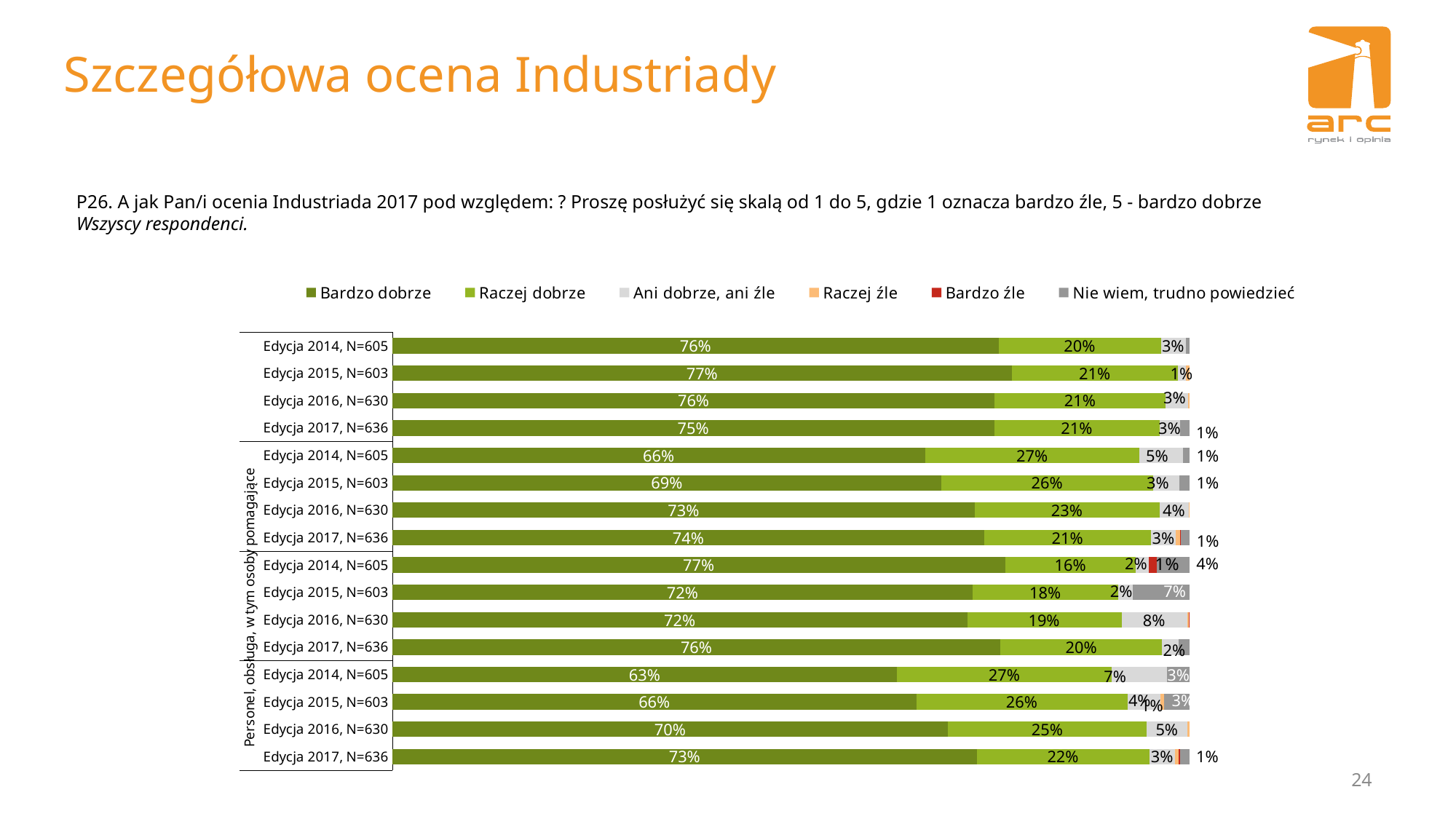
What kind of chart is shown on the slide? Stacked bar chart How many series does the legend list? 6 Across the bottom four bars (Edycja 2014 to Edycja 2017), does the Bardzo dobrze value rise or fall? Rise What is the highest Bardzo dobrze value shown in the chart? 77% In the topmost bar (Edycja 2014, N=605), which is larger: Bardzo dobrze or Raczej dobrze? Bardzo dobrze How many bars are plotted in the chart? 16 What is the lowest Bardzo dobrze value shown in the chart? 63% What is the Bardzo dobrze value for the topmost bar (Edycja 2014, N=605)? 76% In the bottom bar (Edycja 2017, N=636), what is the difference between the Bardzo dobrze and Raczej dobrze values? 51 percentage points Which legend entry is listed first? Bardzo dobrze What is the Raczej dobrze value for the bottom bar (Edycja 2017, N=636)? 22% What is the Bardzo dobrze value for the bottom bar (Edycja 2017, N=636)? 73%